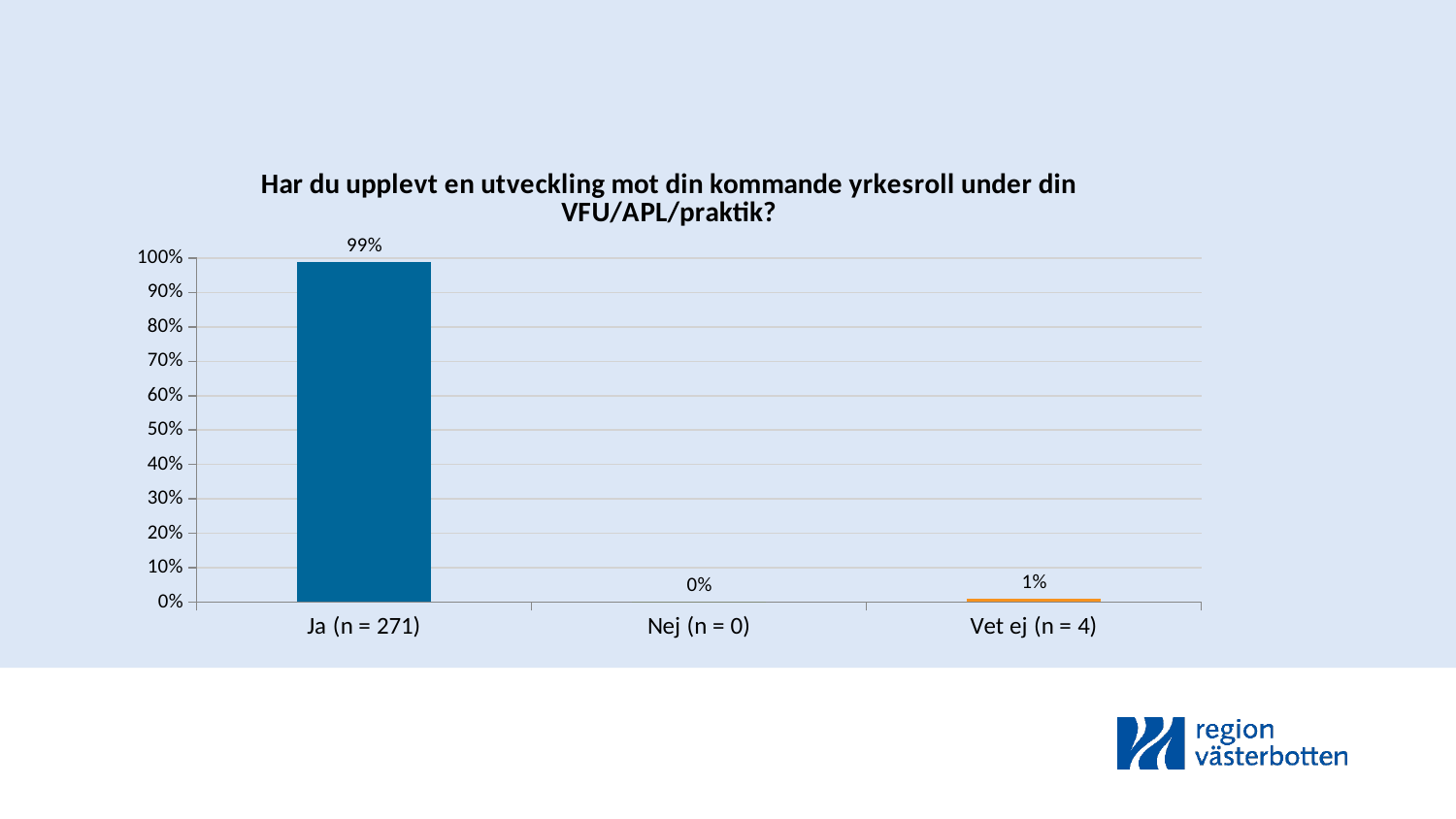
What is the value for Nej (n = 0)? 0% What is the highest value shown on the y axis? 100% Is the value for Ja (n = 271) greater or less than 50%? greater How many categories are shown on the x axis? 3 What is the difference between the values for Ja (n = 271) and Vet ej (n = 4)? 98% Which category has the lowest value? Nej (n = 0) What is the value for Vet ej (n = 4)? 1% Which category has the highest value? Ja (n = 271) What is the title of the chart? Har du upplevt en utveckling mot din kommande yrkesroll under din VFU/APL/praktik? What kind of chart is shown on the slide? Bar chart Which is larger, the value for Vet ej (n = 4) or the value for Nej (n = 0)? Vet ej (n = 4) What is the value for Ja (n = 271)? 99%